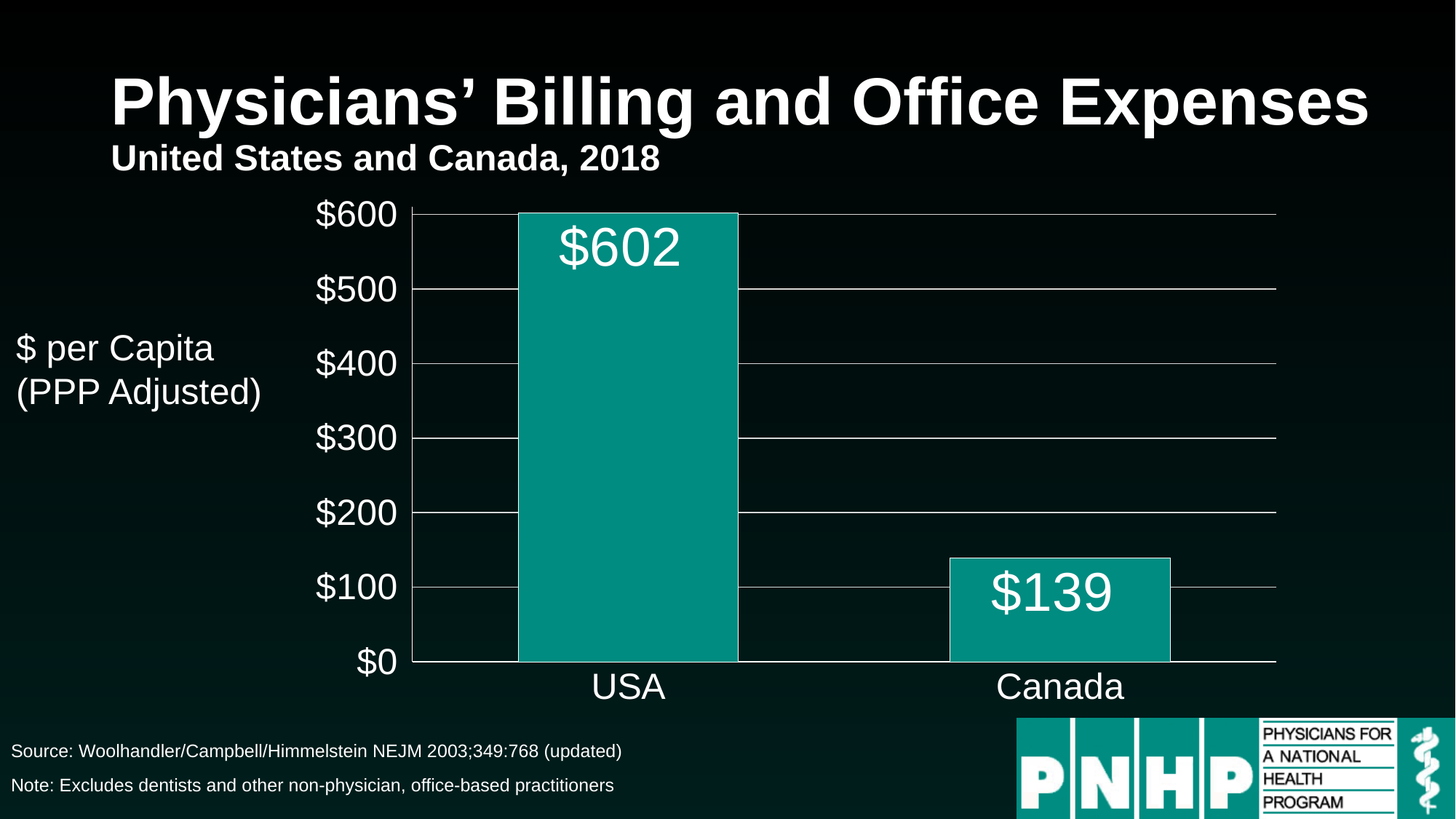
What is the value for USA? $602 What is the label of the vertical axis? $ per Capita (PPP Adjusted) Which country has the lowest physicians' billing and office expenses per capita? Canada How many countries are shown in the chart? 2 What is the difference between the USA and Canada values? $463 What kind of chart is shown on the slide? bar chart Is the value for Canada greater or less than $200? less Which country has the highest physicians' billing and office expenses per capita? USA Is the value for USA greater or less than $500? greater What is the value for Canada? $139 What is the title of the chart? Physicians' Billing and Office Expenses Which is larger, the value for USA or the value for Canada? USA